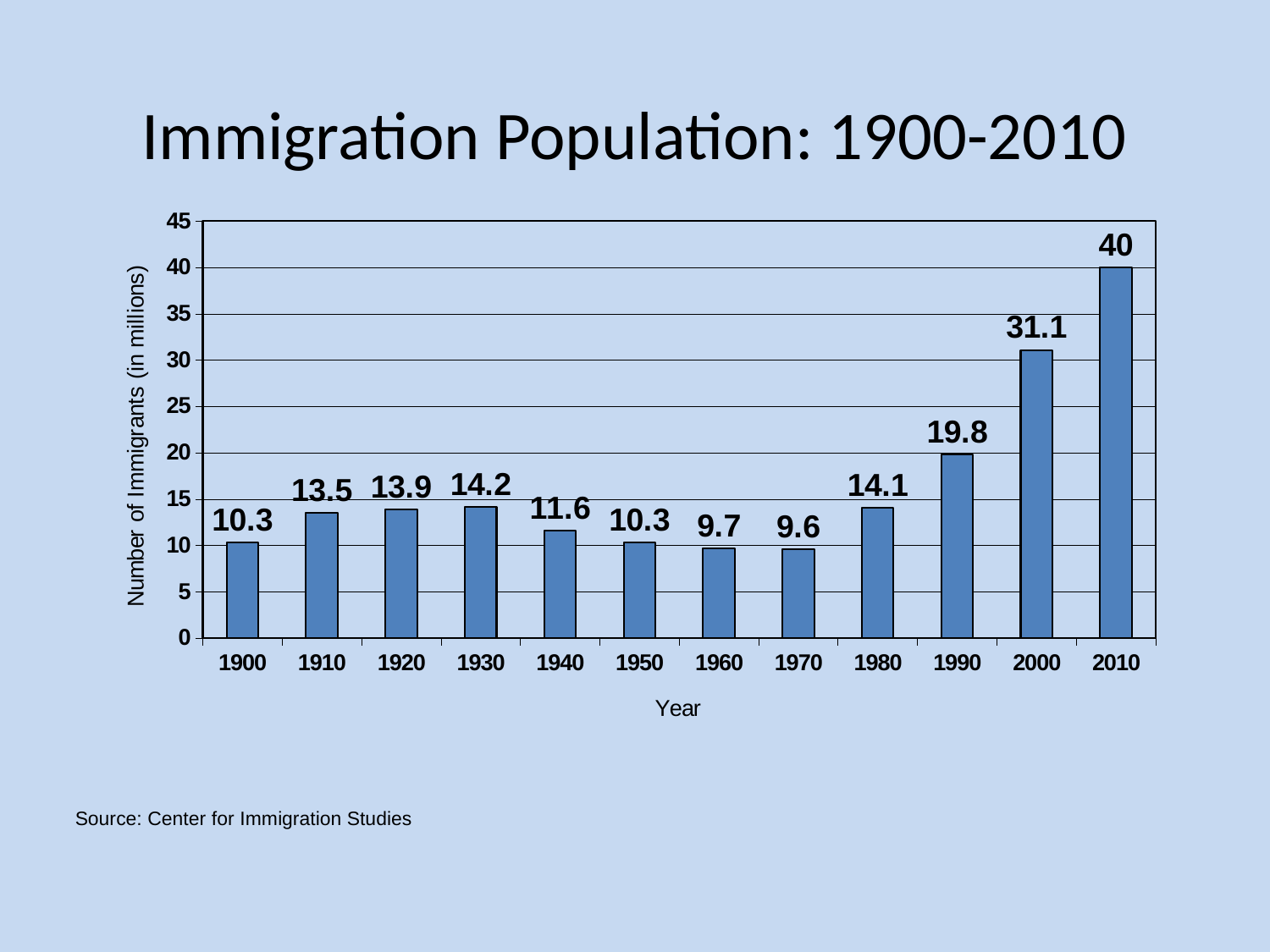
Which is larger, the value for 1940 or the value for 1980? 1980 What is the difference between the values for 1930 and 1900? 3.9 What value is shown for 1990? 19.8 What is the title of the chart? Immigration Population: 1900-2010 What is the difference between the values for 2010 and 2000? 8.9 What kind of chart is shown on the slide? bar chart Is the value for 2000 greater or less than 30? greater What is the number of immigrants (in millions) shown for 1900? 10.3 Which year has the highest number of immigrants? 2010 How many years are shown on the x axis? 12 What value is shown for 2000? 31.1 Which year has the lowest number of immigrants? 1970